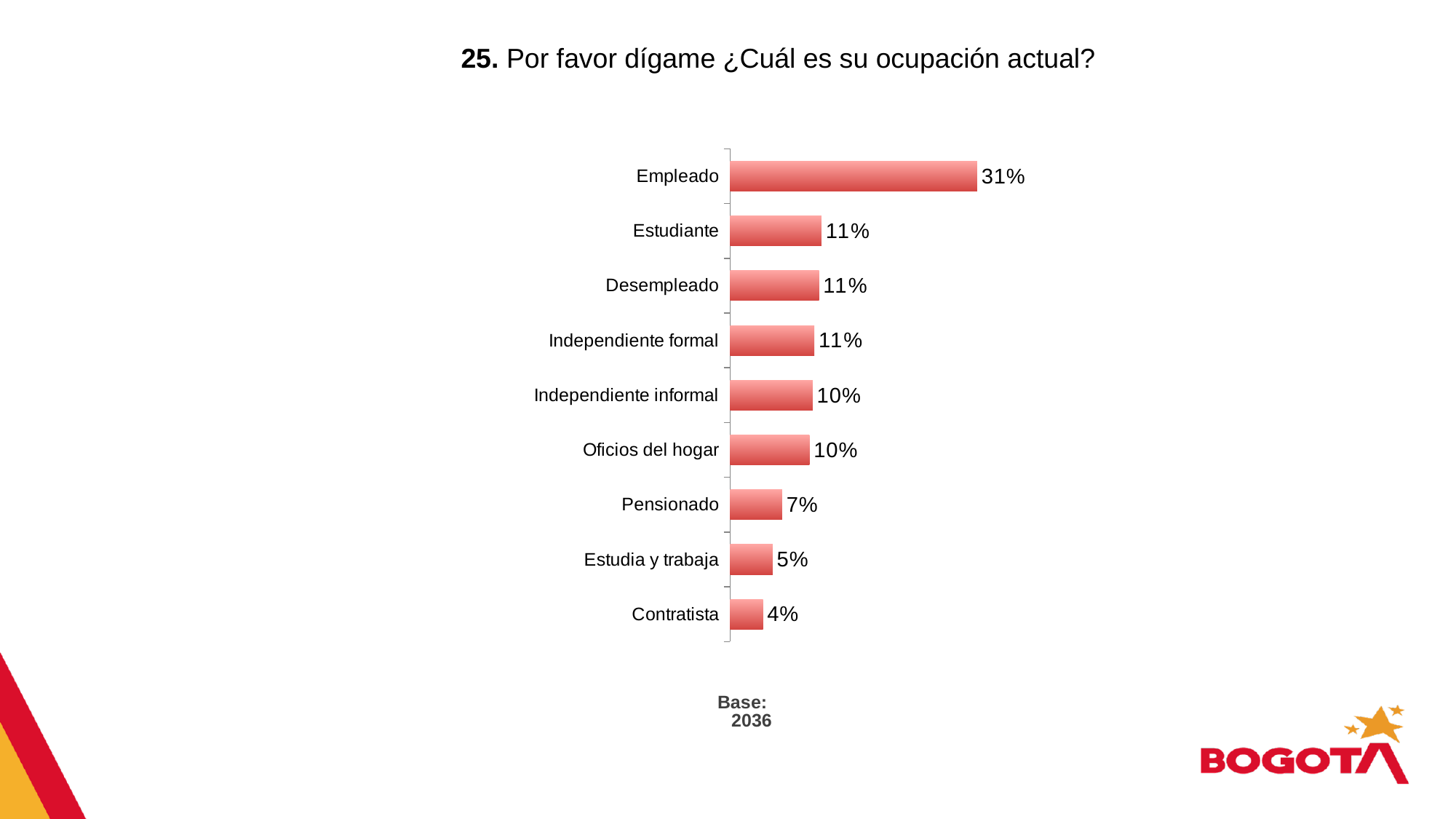
Which is larger, the value for Oficios del hogar or the value for Pensionado? Oficios del hogar What is the difference between the values for Pensionado and Contratista? 3% What is the value for Empleado? 31% How many categories are shown in the chart? 9 Which category has the highest value? Empleado What is the base (number of respondents) shown below the chart? 2036 What is the value for Contratista? 4% What is the value for Pensionado? 7% What is the value for Estudia y trabaja? 5% What kind of chart is shown on the slide? Bar chart Which category has the lowest value? Contratista What is the difference between the values for Empleado and Estudiante? 20%